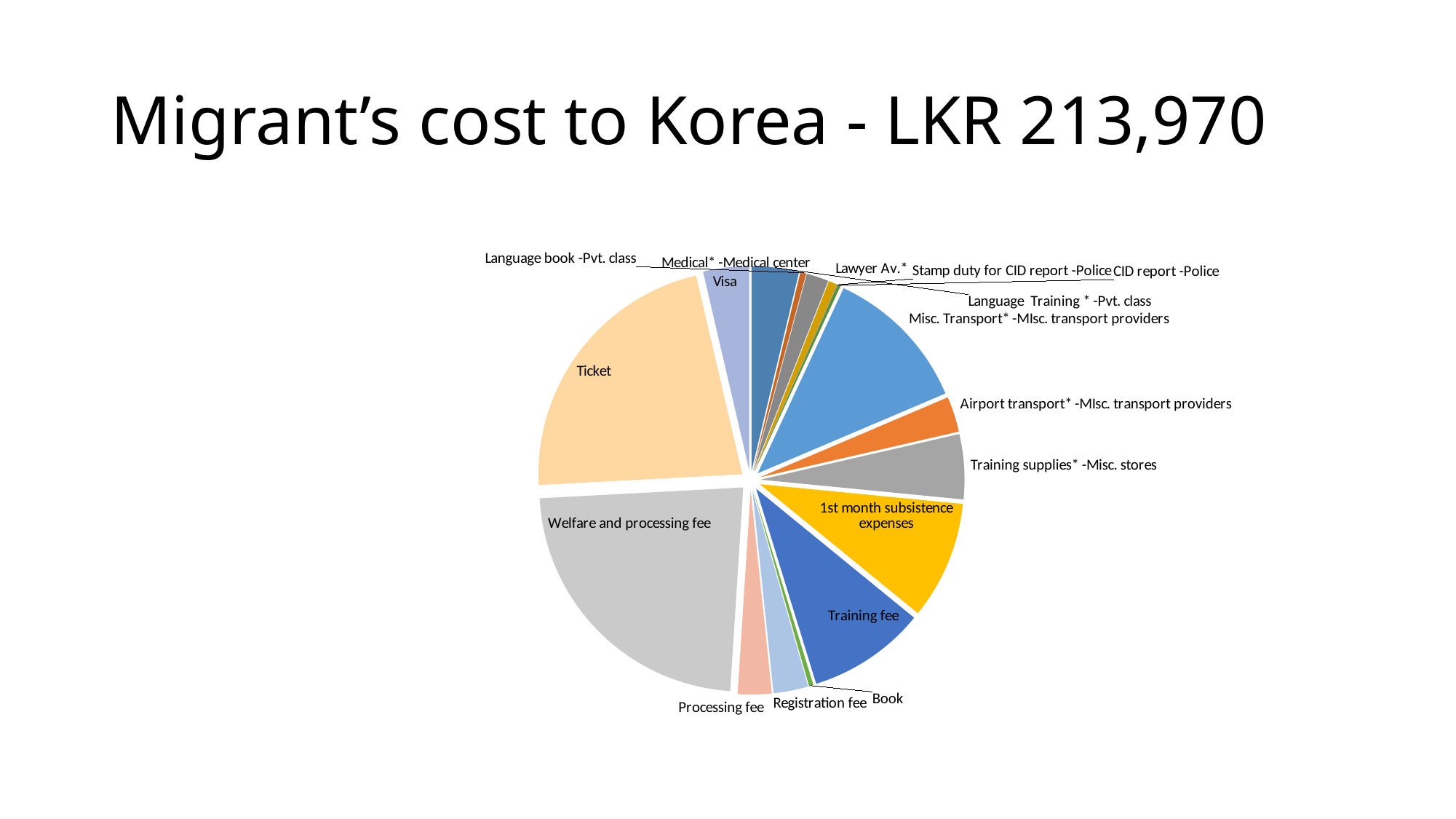
Which slice is larger: Visa or Registration fee? Visa Which category has the largest slice of the pie? Welfare and processing fee What total cost is stated in the slide title? LKR 213,970 Which slice is larger: Welfare and processing fee or Ticket? Welfare and processing fee What kind of chart is shown on the slide? Pie chart Which slice is larger: Misc. Transport* -MIsc. transport providers or Airport transport* -MIsc. transport providers? Misc. Transport* -MIsc. transport providers What is the title of the slide? Migrant's cost to Korea - LKR 213,970